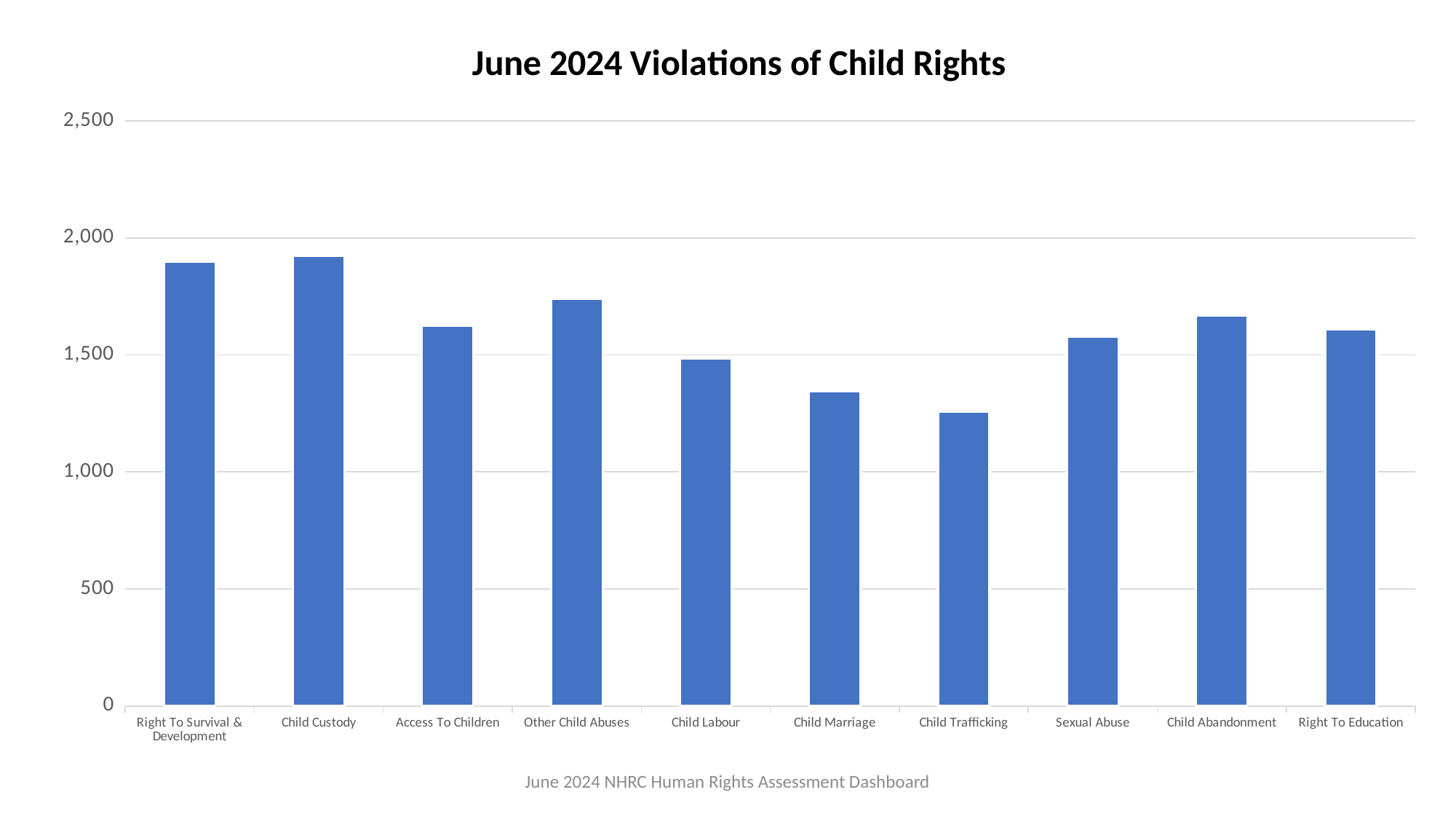
What is the title of the chart? June 2024 Violations of Child Rights What source is cited below the chart? June 2024 NHRC Human Rights Assessment Dashboard Is the value for Child Trafficking greater or less than 1,500? less Which is larger, the value for Child Abandonment or the value for Sexual Abuse? Child Abandonment Is the value for Child Custody greater or less than 1,500? greater Is the value for Right To Survival & Development greater or less than 2,000? less Which category has the lowest value? Child Trafficking Which is larger, the value for Other Child Abuses or the value for Child Labour? Other Child Abuses What kind of chart is shown on the slide? Bar chart How many categories are plotted on the chart? 10